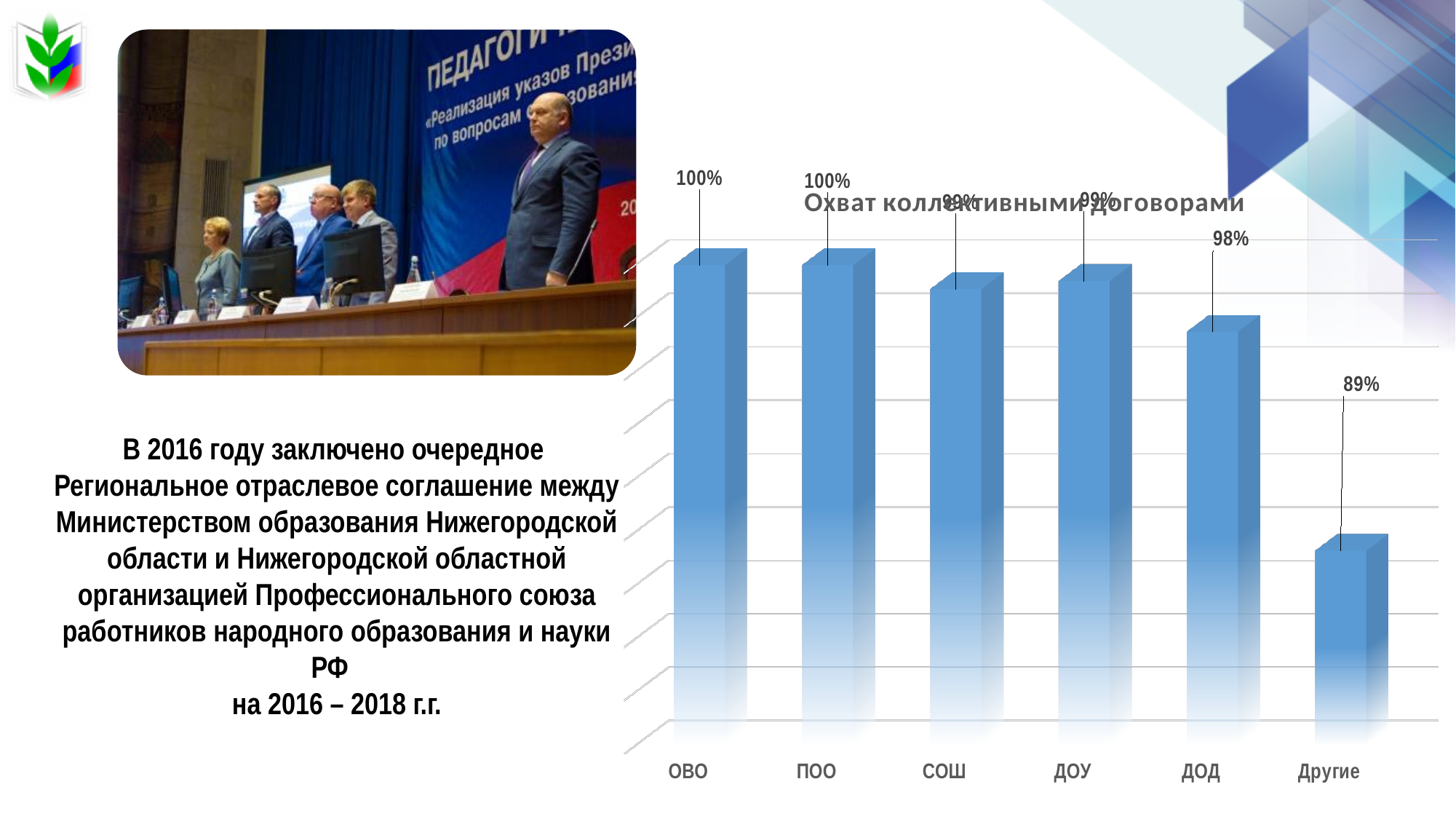
What is the value for ОВО in the chart? 100% What is the value for СОШ in the chart? 99% What is the value for ДОД in the chart? 98% Which category has the lowest value in the chart? Другие What is the value for Другие in the chart? 89% What is the value for ПОО in the chart? 100% What is the difference between the values for ОВО and Другие? 11% How many categories are shown in the chart? 6 What is the title of the chart? Охват коллективными договорами Which has a larger value, ДОД or Другие? ДОД What kind of chart is shown on the slide? Bar chart What is the difference between the values for ДОД and Другие? 9%